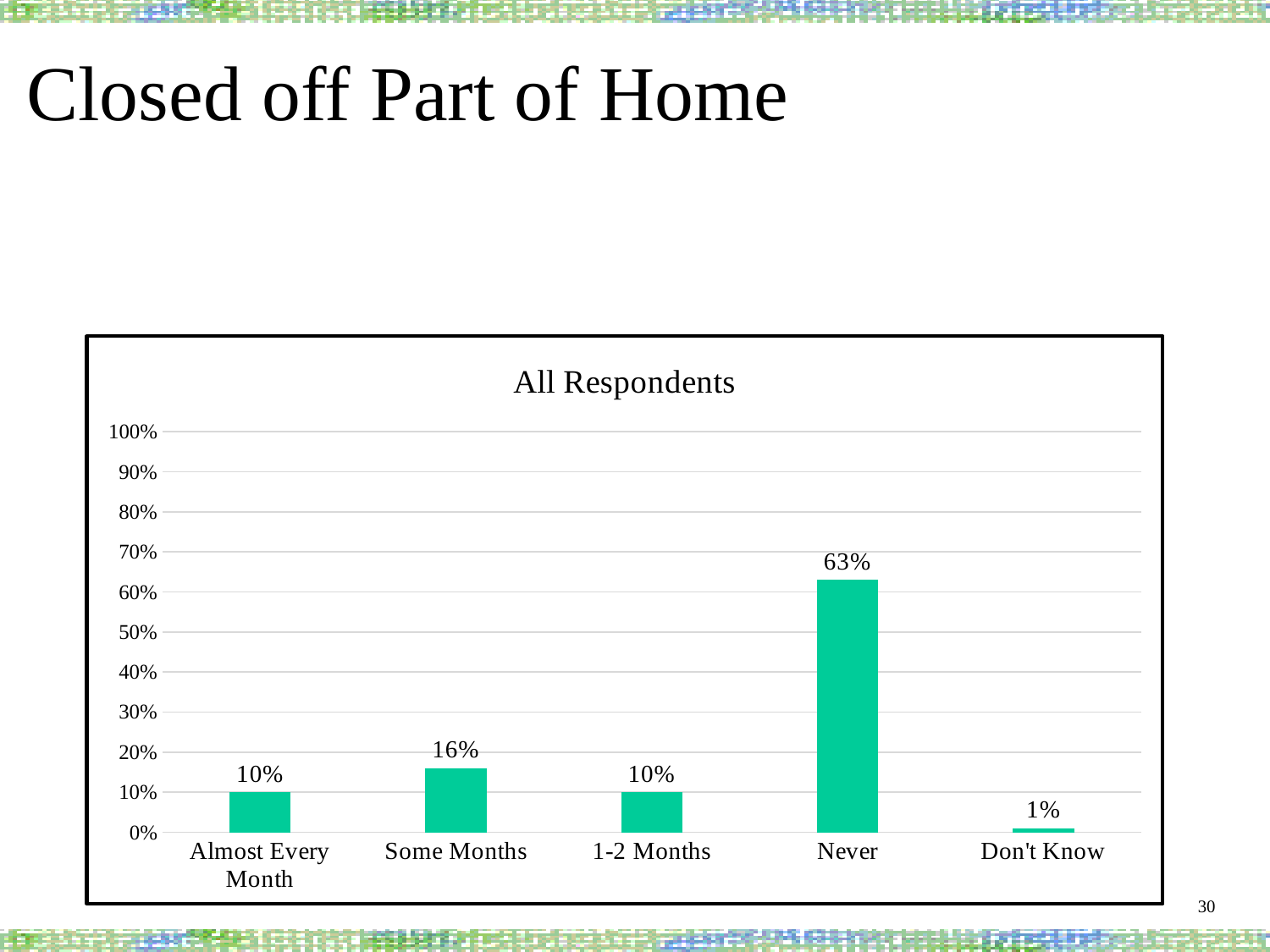
Which is larger, the value for Some Months or the value for 1-2 Months? Some Months What is the value for Almost Every Month? 10% What is the value for Never? 63% What is the title of the chart? All Respondents Which category has the lowest value? Don't Know Which category has the highest value? Never What is the value for Some Months? 16% What kind of chart is shown on the slide? bar chart What is the value for Don't Know? 1% Is the value for Never greater or less than 50%? greater How many categories are shown on the x axis? 5 What is the difference between the values for Never and Some Months? 47%